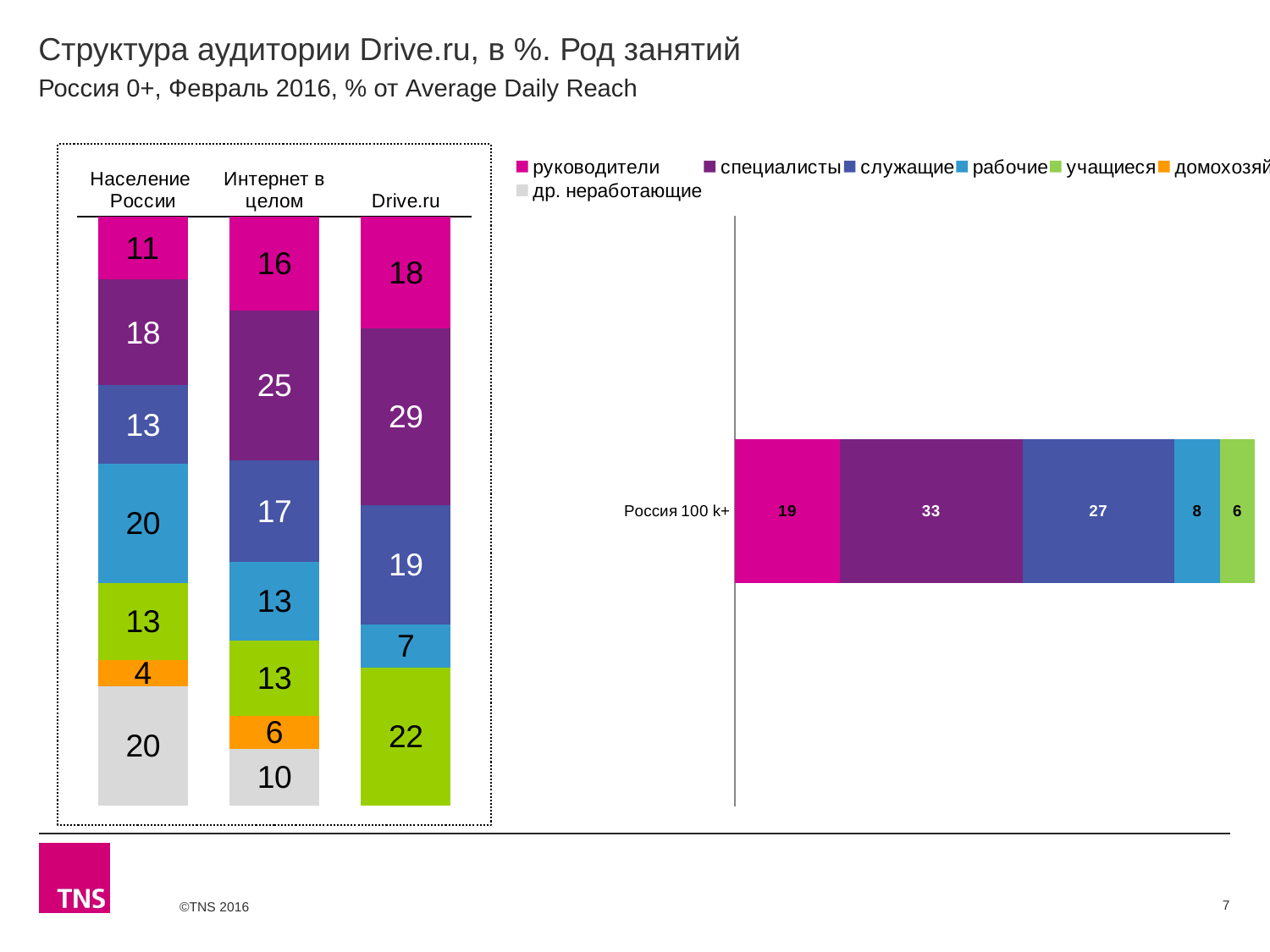
In the left chart, what is the value of the домохозяйки segment for Интернет в целом? 6 In the right chart, what is the total of the Россия 100 k+ bar? 93 In the left chart, which segment is the smallest in the Население России bar? домохозяйки In the right chart, what is the value of the служащие segment for Россия 100 k+? 27 In the left chart, which segment is the largest in the Drive.ru bar? специалисты In the left chart, what is the value of the специалисты segment for Drive.ru? 29 How many series does the legend list? 7 How many bars (categories) are shown in the left chart? 3 In the left chart, which is larger: the руководители value for Drive.ru or for Население России? Drive.ru In the left chart, what is the value of the рабочие segment for Население России? 20 In the left chart, what is the difference between the учащиеся values for Drive.ru and Интернет в целом? 9 What kind of chart is the right chart? stacked bar chart